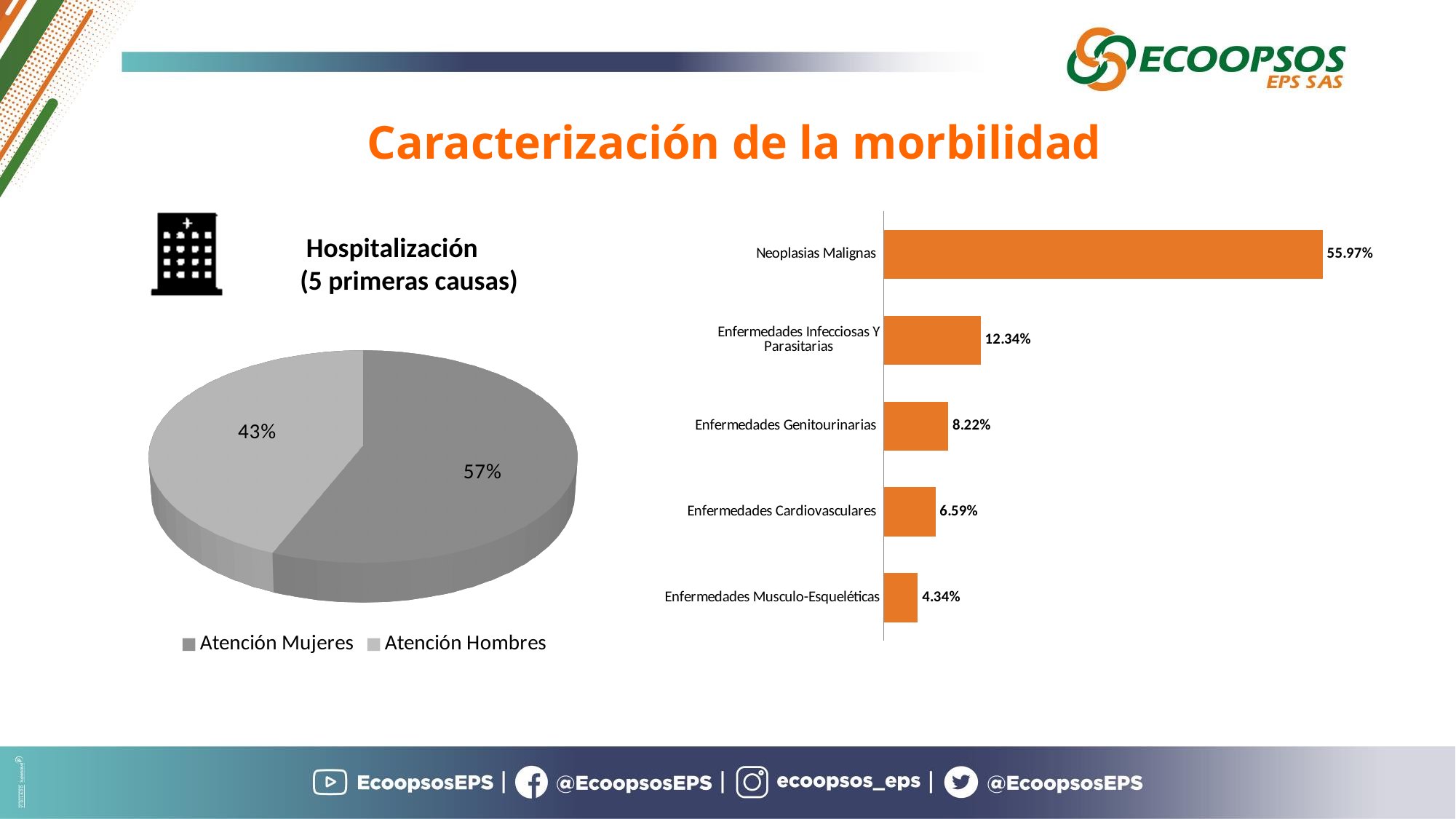
In the bar chart on the right, which category has the lowest value? Enfermedades Musculo-Esqueléticas How many categories are shown in the bar chart on the right? 5 What kind of chart is the chart on the left of the slide? Pie chart In the bar chart on the right, what is the difference between Enfermedades Infecciosas Y Parasitarias and Enfermedades Cardiovasculares? 5.75% In the bar chart on the right, which category has the highest value? Neoplasias Malignas What kind of chart is the chart on the right of the slide? Bar chart In the bar chart on the right, what is the value for Neoplasias Malignas? 55.97% In the pie chart on the left, what share is Atención Hombres? 43% In the pie chart on the left, which slice is larger, Atención Mujeres or Atención Hombres? Atención Mujeres In the bar chart on the right, what is the value for Enfermedades Genitourinarias? 8.22% In the pie chart on the left, what share is Atención Mujeres? 57% How many entries does the legend of the pie chart on the left list? 2